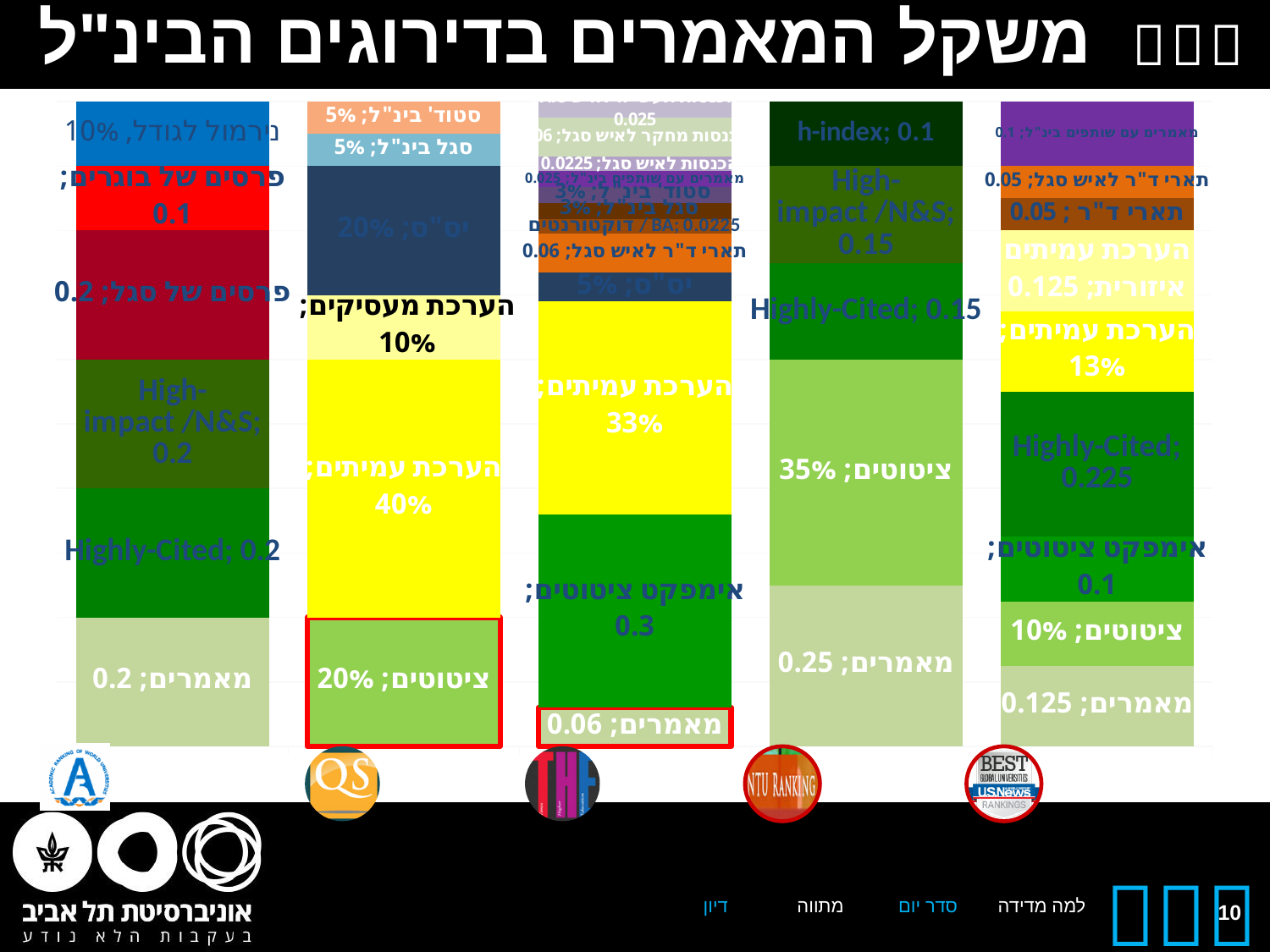
Which is larger: the 'מאמרים' segment in the fourth bar (NTU) or the 'מאמרים' segment in the rightmost bar (US News)? NTU (0.25) In the middle bar (THE), what is the value of the 'מאמרים' segment? 0.06 What kind of chart is shown on the slide? stacked bar chart In the middle bar (THE), what is the value of the 'אימפקט ציטוטים' segment? 0.3 In the fourth bar from the left (NTU), what is the value of the 'ציטוטים' segment? 35% In the fourth bar from the left (NTU), what is the value of the 'h-index' segment? 0.1 In the rightmost bar (US News), what is the value of the 'Highly-Cited' segment? 0.225 How many stacked bars (rankings) are shown in the chart? 5 In the second bar from the left (QS), what is the value of the 'ציטוטים' segment? 20% What is the difference between the 'Highly-Cited' value in the leftmost bar (ARWU) and the 'Highly-Cited' value in the fourth bar (NTU)? 0.05 In the leftmost bar (ARWU), what is the value of the 'מאמרים' segment? 0.2 In the second bar from the left (QS), what is the value of the 'הערכת עמיתים' segment? 40%